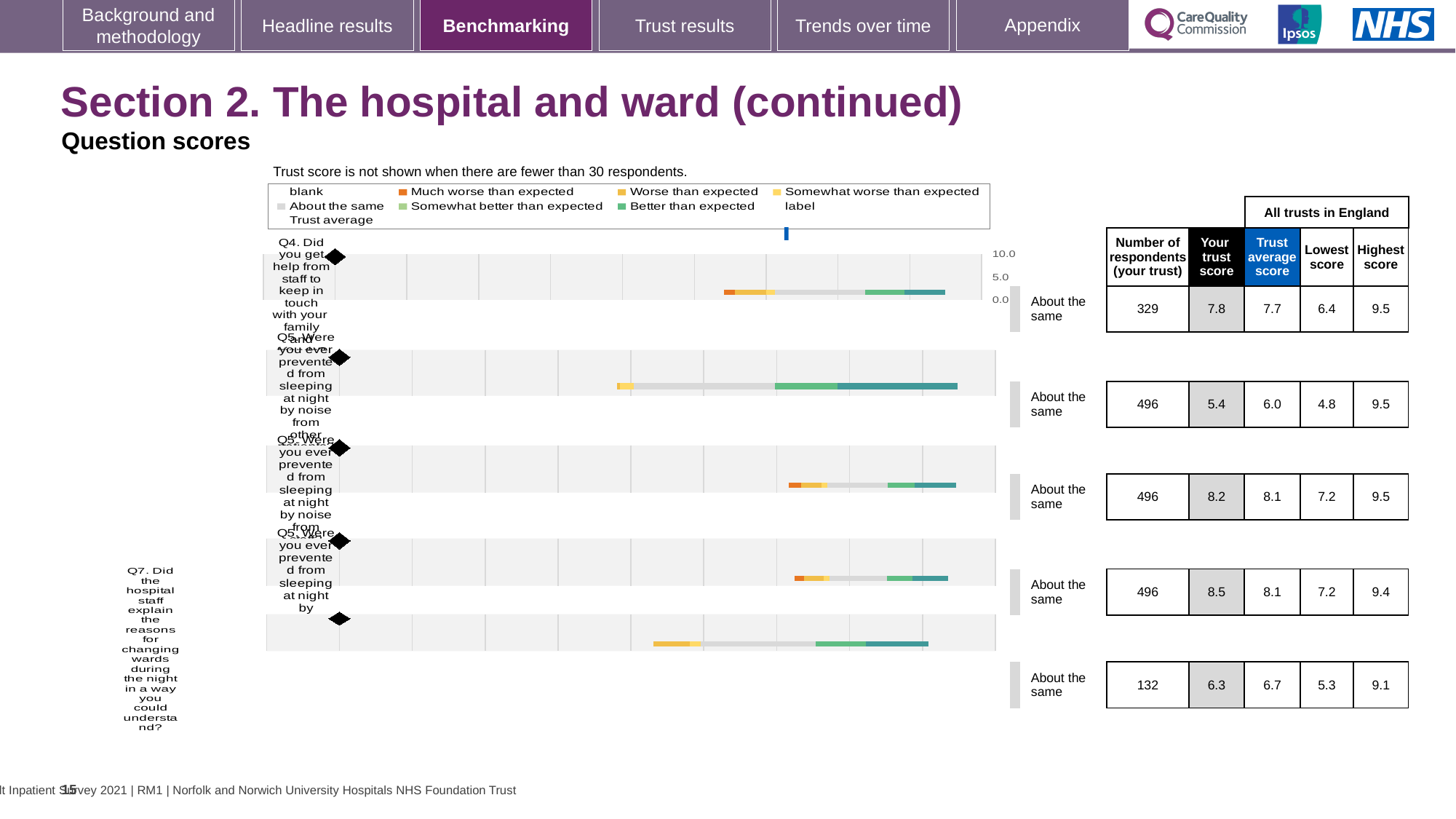
What is the number of respondents for the top row (Q4)? 329 Which row has the lowest 'Your trust score'? the second row (5.4) What is the trust score for the bottom row (Q7, explaining reasons for changing wards during the night)? 6.3 What is the difference between the trust average score and the trust score for the bottom row (Q7)? 0.4 For the top row (Q4), which is larger: the trust score or the trust average score? the trust score (7.8) How many question rows are plotted in the chart? 5 What benchmark category is shown next to every question row? About the same What is the trust average score for the bottom row (Q7)? 6.7 Which row has the highest 'Your trust score'? the fourth row (8.5) What colour represents 'Much worse than expected' in the legend? orange What is the trust score for the top row (Q4, help from staff to keep in touch with family and friends)? 7.8 What kind of chart is used to show the question scores on this slide? bar chart